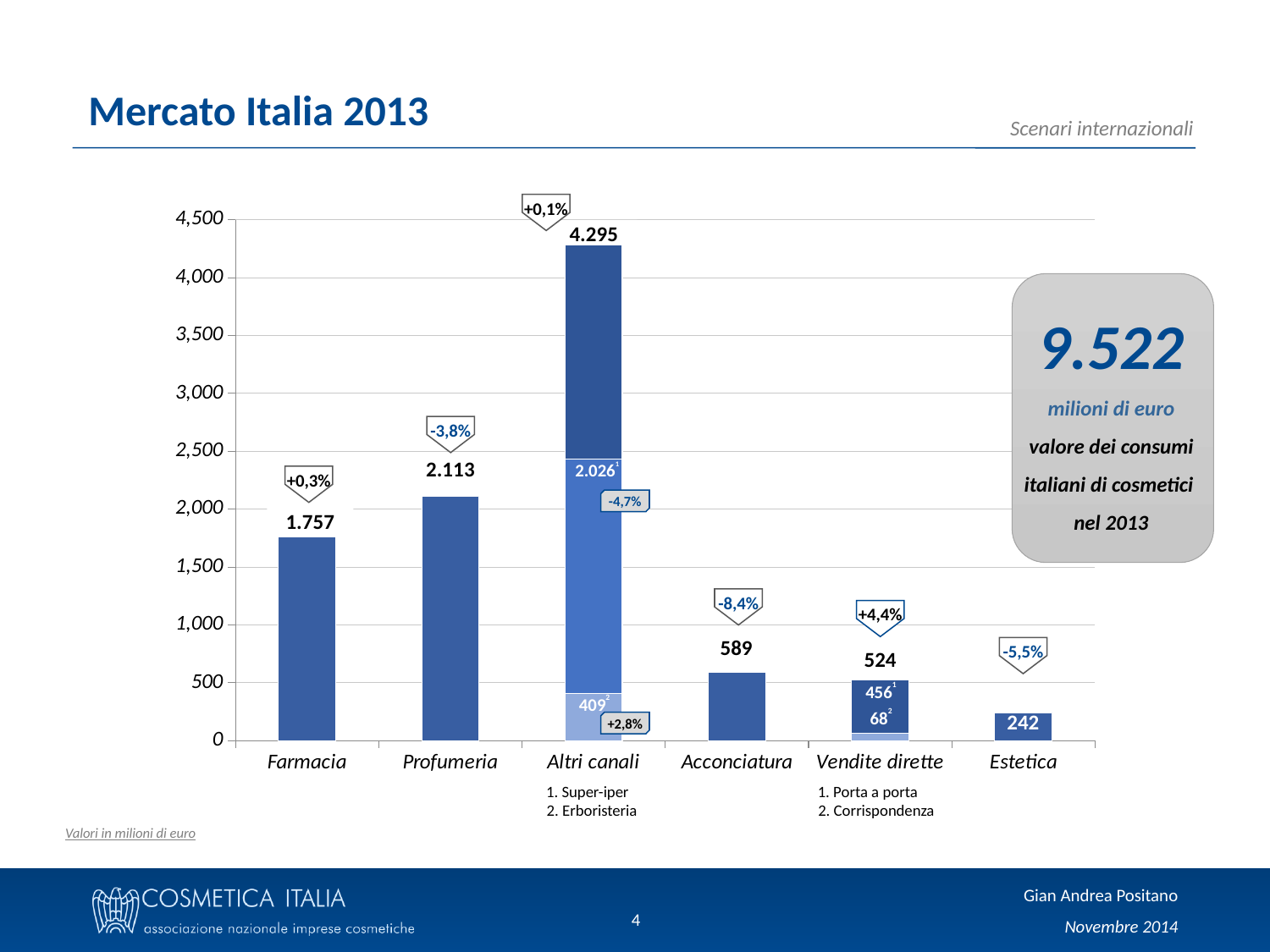
Which is larger, the value for Acconciatura or the value for Vendite dirette? Acconciatura Is the value for Acconciatura greater or less than 500? greater What is the difference between the values for Profumeria and Farmacia? 356 What is the value for Farmacia? 1.757 What is the title of the slide containing the chart? Mercato Italia 2013 Which category has the lowest value? Estetica What kind of chart is shown on the slide? bar chart What is the value labelled for the Super-iper segment within Altri canali? 2.026 What is the value for Profumeria? 2.113 Which category has the highest value? Altri canali What percentage change is shown above the Acconciatura bar? -8,4% How many categories are shown on the x axis? 6